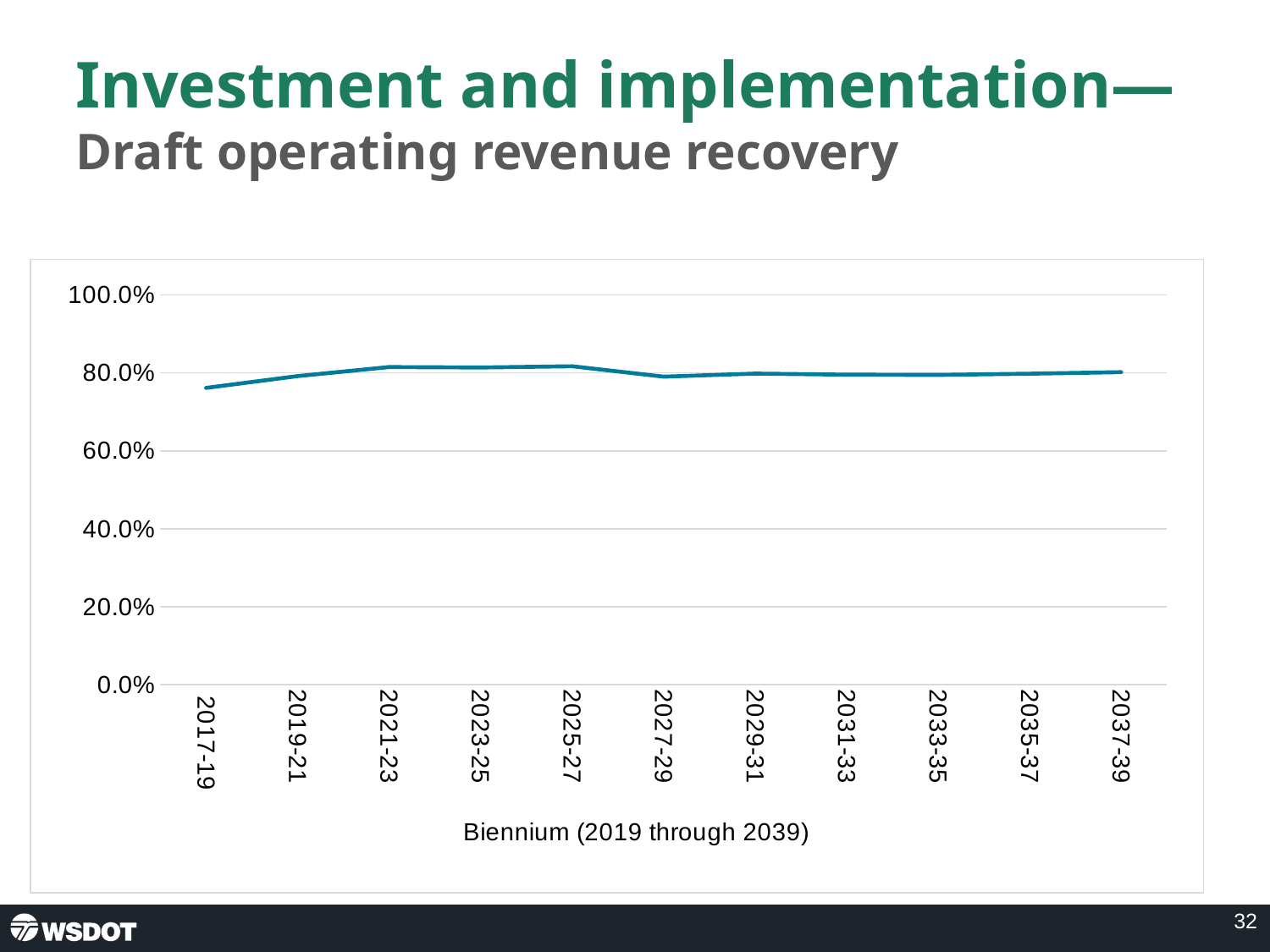
Which biennium has the lowest value on the line? 2017-19 What is the highest value shown on the y axis? 100.0% Does the line rise or fall from 2017-19 to 2021-23? rise How many biennia are plotted along the x axis? 11 Is the value for 2037-39 greater or less than 60.0%? greater Is the value for 2017-19 greater or less than 60.0%? greater What is the title of the x axis? Biennium (2019 through 2039) Is the value for 2025-27 greater or less than 80.0%? greater Which is larger, the value for 2025-27 or the value for 2027-29? 2025-27 What kind of chart is shown on the slide? line chart Which is larger, the value for 2017-19 or the value for 2025-27? 2025-27